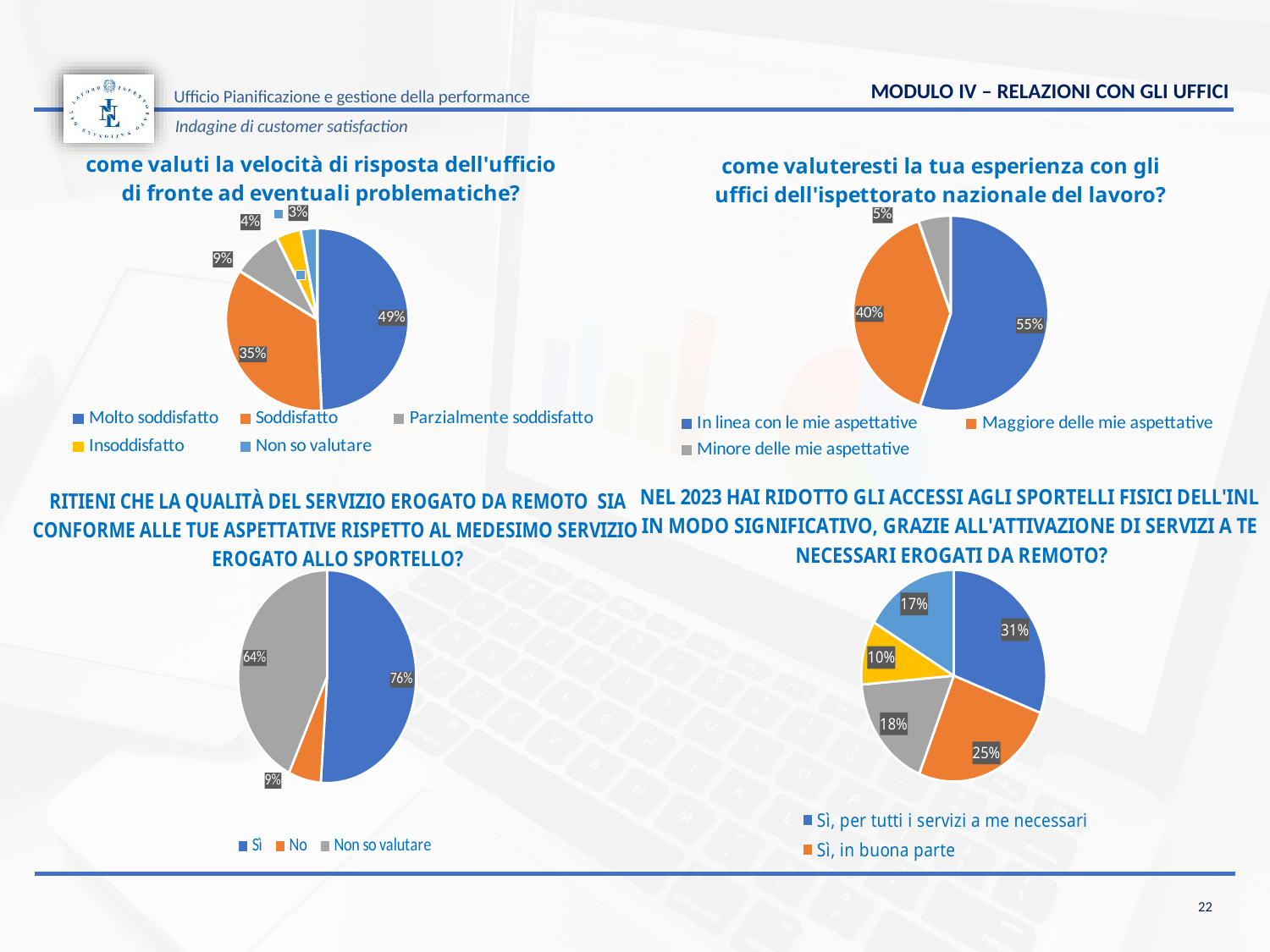
In the chart 'come valuteresti la tua esperienza con gli uffici dell'ispettorato nazionale del lavoro?', what share is 'In linea con le mie aspettative'? 55% In the chart 'RITIENI CHE LA QUALITÀ DEL SERVIZIO EROGATO DA REMOTO SIA CONFORME ALLE TUE ASPETTATIVE...', what share is labelled for 'Sì'? 76% In the chart 'come valuti la velocità di risposta dell'ufficio di fronte ad eventuali problematiche?', which category has the smallest share? Non so valutare In the chart 'come valuteresti la tua esperienza con gli uffici dell'ispettorato nazionale del lavoro?', what is the difference between 'In linea con le mie aspettative' and 'Maggiore delle mie aspettative'? 15 percentage points In the chart 'come valuti la velocità di risposta dell'ufficio di fronte ad eventuali problematiche?', what share is 'Molto soddisfatto'? 49% What kind of chart is used for 'come valuti la velocità di risposta dell'ufficio di fronte ad eventuali problematiche?'? Pie chart In the chart 'come valuti la velocità di risposta dell'ufficio di fronte ad eventuali problematiche?', what is the difference between 'Molto soddisfatto' and 'Soddisfatto'? 14 percentage points In the chart 'come valuti la velocità di risposta dell'ufficio di fronte ad eventuali problematiche?', what share is 'Soddisfatto'? 35% How many entries does the legend list for the chart 'come valuti la velocità di risposta dell'ufficio di fronte ad eventuali problematiche?'? 5 In the chart 'NEL 2023 HAI RIDOTTO GLI ACCESSI AGLI SPORTELLI FISICI DELL'INL...', which is larger: 'Sì, per tutti i servizi a me necessari' or 'Sì, in buona parte'? Sì, per tutti i servizi a me necessari How many slices does the chart 'come valuteresti la tua esperienza con gli uffici dell'ispettorato nazionale del lavoro?' have? 3 In the chart 'come valuteresti la tua esperienza con gli uffici dell'ispettorato nazionale del lavoro?', which category has the largest share? In linea con le mie aspettative